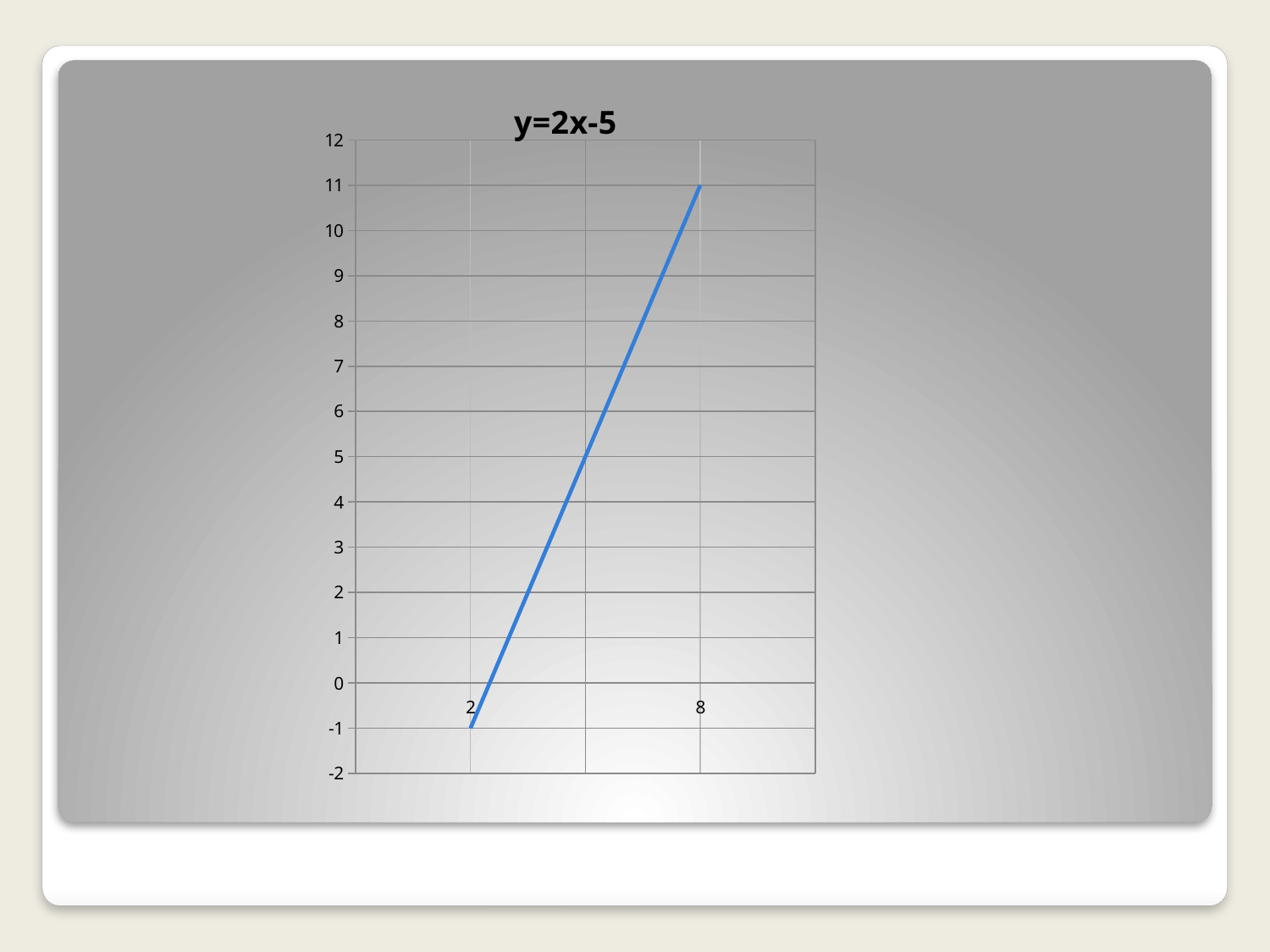
What is the difference between the y value at x = 8 and the y value at x = 2? 12 What is the value of y at x = 8? 11 At which x value is y highest? 8 Which is larger, the y value at x = 2 or at x = 8? x = 8 What is the value of y at x = 2? -1 What colour is the plotted line? blue Does the line rise or fall from x = 2 to x = 8? rise What is the title of the chart? y=2x-5 How many points are plotted on the line? 2 Is the y value at x = 8 greater or less than 10? greater At which x value is y lowest? 2 What kind of chart is shown on the slide? line chart